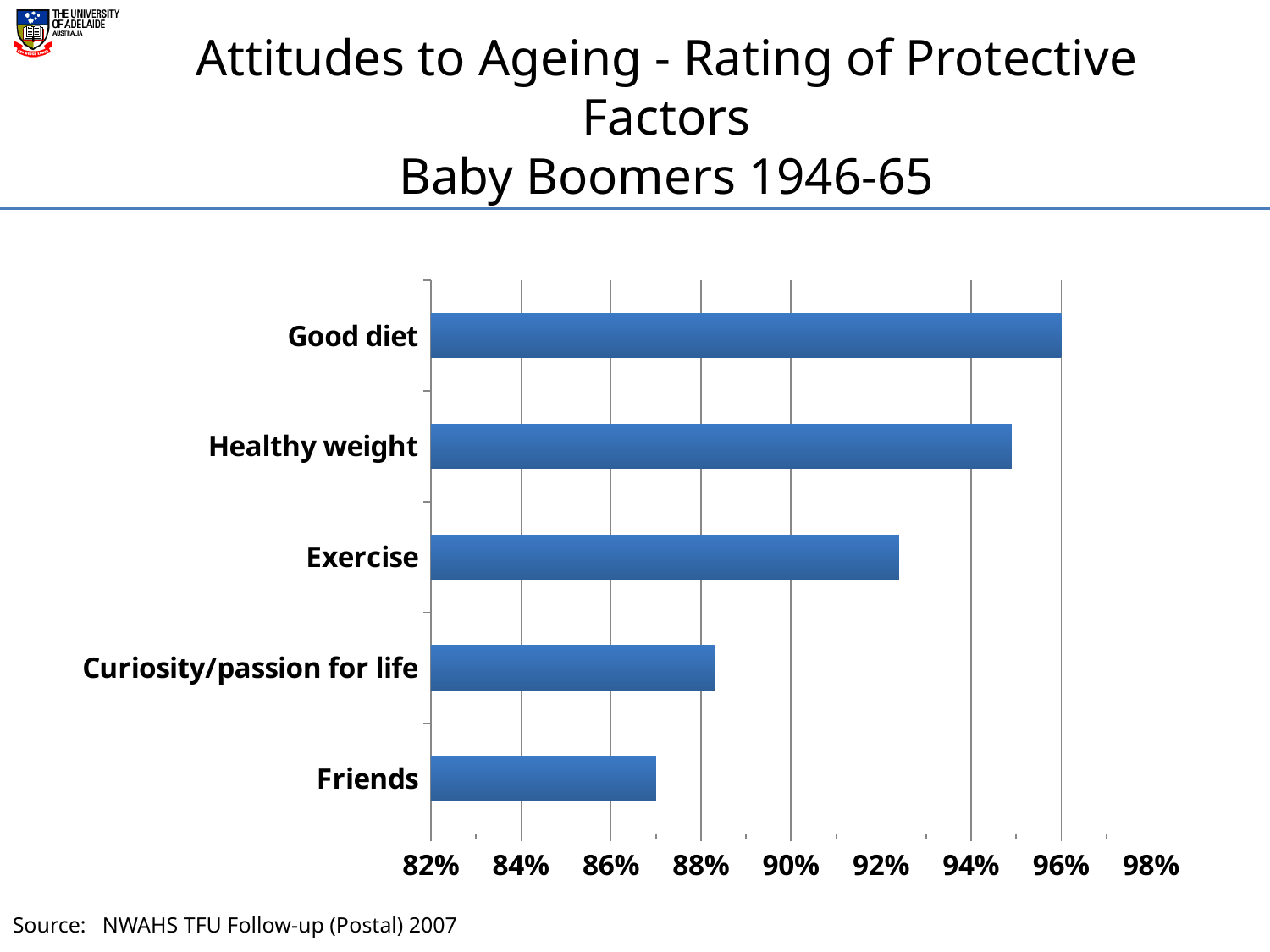
Is the value for Exercise greater or less than 94%? less Is the value for Friends greater or less than 88%? less What kind of chart is shown on the slide? bar chart Is the value for Healthy weight greater or less than 94%? greater Do the bar values decrease or increase going from the top category to the bottom category? decrease Which is rated higher, Healthy weight or Exercise? Healthy weight What is the source cited for the chart data? NWAHS TFU Follow-up (Postal) 2007 Which protective factor has the lowest rating? Friends Which is rated higher, Friends or Curiosity/passion for life? Curiosity/passion for life How many protective factors are plotted in the chart? 5 Which protective factor has the highest rating? Good diet